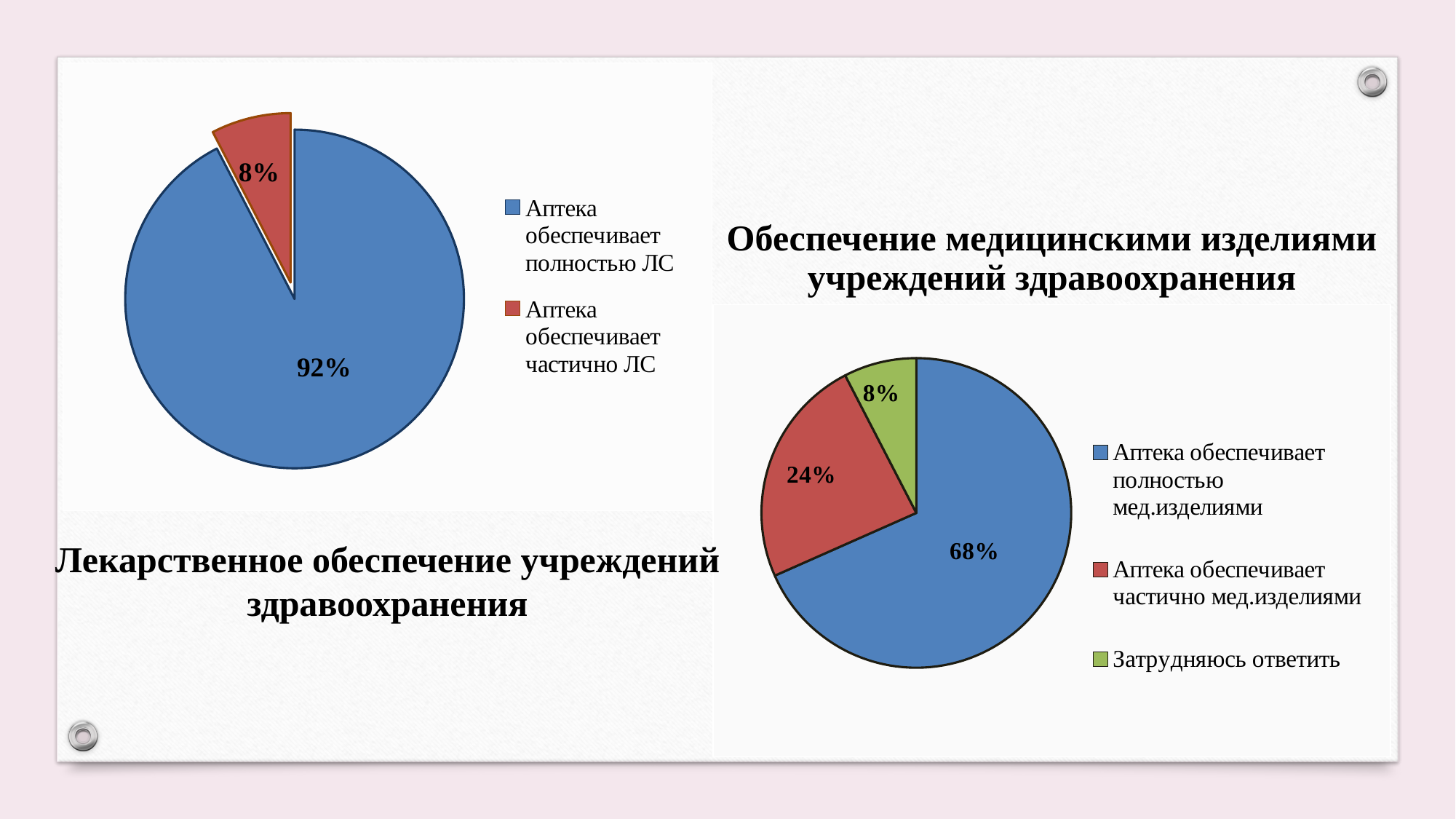
In the right chart 'Обеспечение медицинскими изделиями учреждений здравоохранения', what is the difference between 'Аптека обеспечивает полностью мед.изделиями' and 'Аптека обеспечивает частично мед.изделиями'? 44% In the left chart 'Лекарственное обеспечение учреждений здравоохранения', how many slices does the pie have? 2 What kind of chart is the left chart 'Лекарственное обеспечение учреждений здравоохранения'? Pie chart In the left chart 'Лекарственное обеспечение учреждений здравоохранения', what is the difference between the two slices? 84% In the left chart 'Лекарственное обеспечение учреждений здравоохранения', what share is labelled for 'Аптека обеспечивает частично ЛС'? 8% In the right chart 'Обеспечение медицинскими изделиями учреждений здравоохранения', what share is labelled for 'Аптека обеспечивает полностью мед.изделиями'? 68% In the right chart 'Обеспечение медицинскими изделиями учреждений здравоохранения', what share is labelled for 'Затрудняюсь ответить'? 8% In the left chart 'Лекарственное обеспечение учреждений здравоохранения', what share is labelled for 'Аптека обеспечивает полностью ЛС'? 92% In the right chart 'Обеспечение медицинскими изделиями учреждений здравоохранения', which category has the smallest slice? Затрудняюсь ответить In the right chart 'Обеспечение медицинскими изделиями учреждений здравоохранения', how many categories does the legend list? 3 In the right chart 'Обеспечение медицинскими изделиями учреждений здравоохранения', what colour is the slice for 'Затрудняюсь ответить'? Green In the right chart 'Обеспечение медицинскими изделиями учреждений здравоохранения', what share is labelled for 'Аптека обеспечивает частично мед.изделиями'? 24%